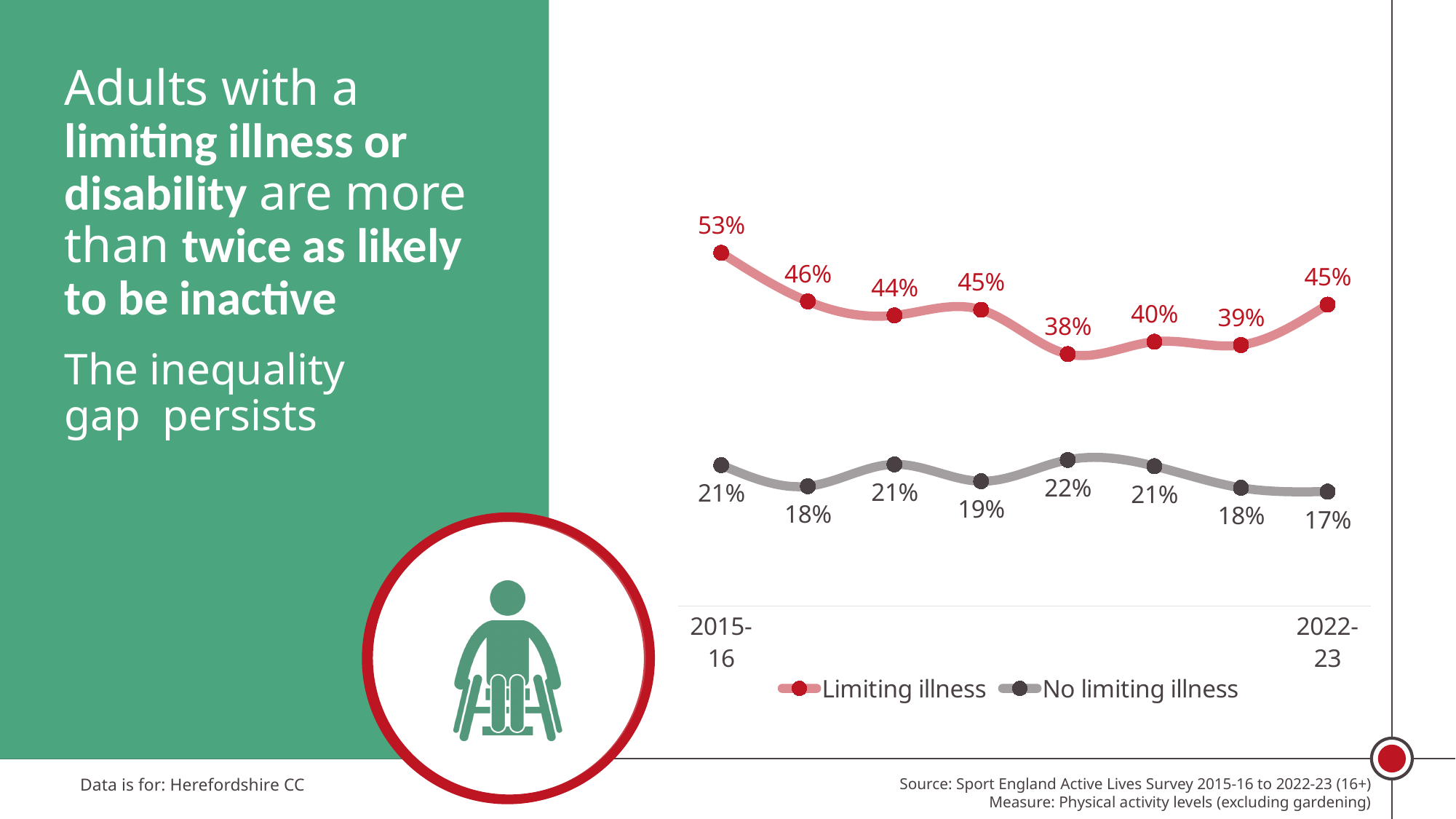
What is the value for Limiting illness in 2015-16? 53% What is the highest value shown for the Limiting illness series? 53% How many data points are plotted for each series? 8 What is the difference between the Limiting illness and No limiting illness values in 2022-23? 28 percentage points Which series has the higher value in 2022-23, Limiting illness or No limiting illness? Limiting illness What is the difference between the Limiting illness and No limiting illness values in 2015-16? 32 percentage points What is the value for No limiting illness in 2022-23? 17% How many series does the chart's legend list? 2 What is the highest value shown for the No limiting illness series? 22% What kind of chart is shown on the slide? Line chart What is the value for Limiting illness in 2022-23? 45% What is the lowest value shown for the Limiting illness series? 38%